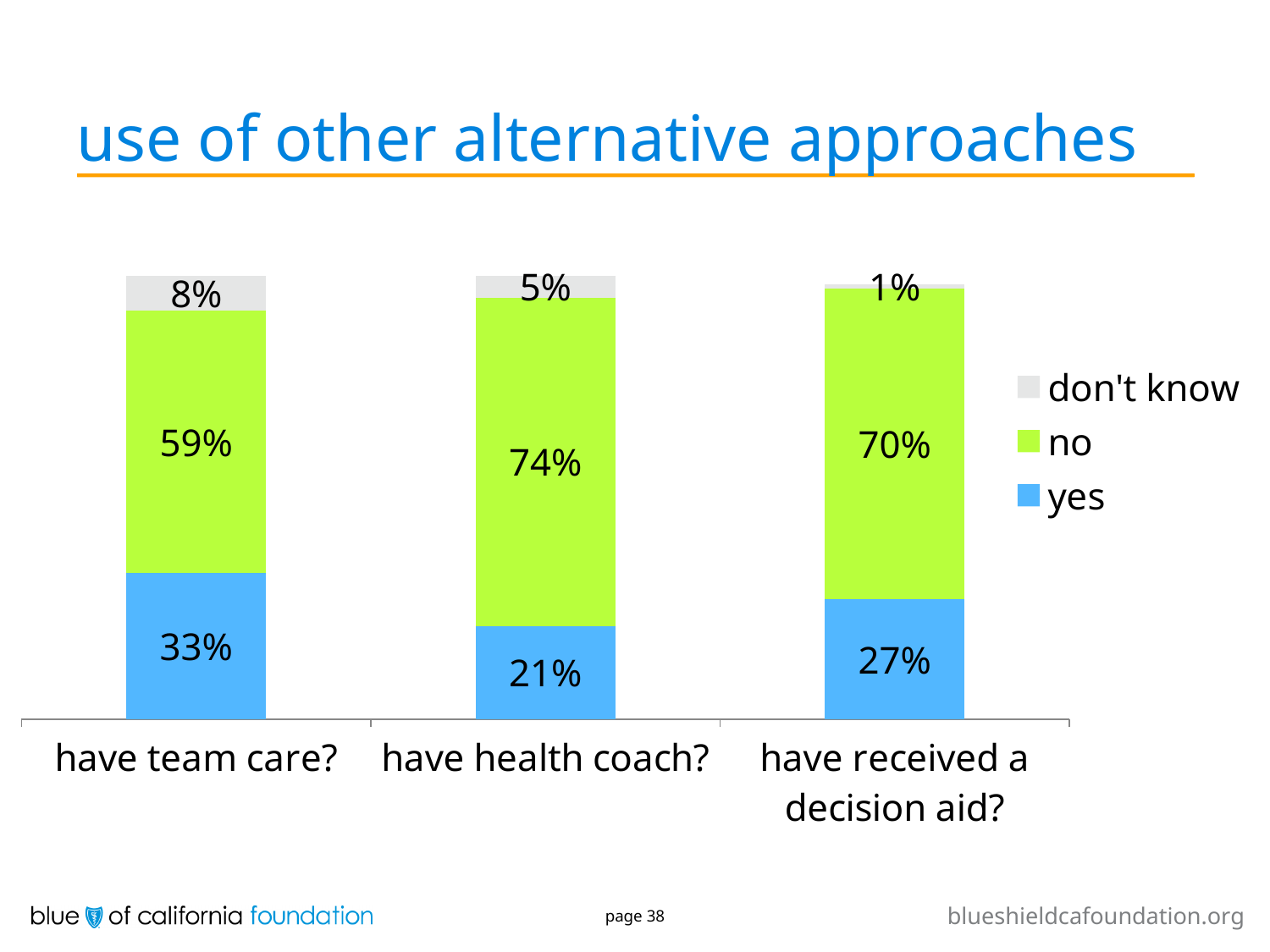
What is the total of the stacked bar for "have team care?" 100% What percentage answered "don't know" to "have received a decision aid?" 1% Which question has the highest "yes" percentage? have team care? What percentage answered "no" to "have health coach?" 74% What kind of chart is shown on the slide? stacked bar chart Which is larger: the "yes" percentage for "have received a decision aid?" or the "yes" percentage for "have health coach?" have received a decision aid? How many series does the legend list? 3 Which question has the lowest "yes" percentage? have health coach? What colour represents the "no" series in the chart? green What is the difference between the "no" percentage for "have health coach?" and the "no" percentage for "have team care?" 15% What percentage answered "yes" to "have team care?" 33% How many questions (categories) are shown on the x axis? 3